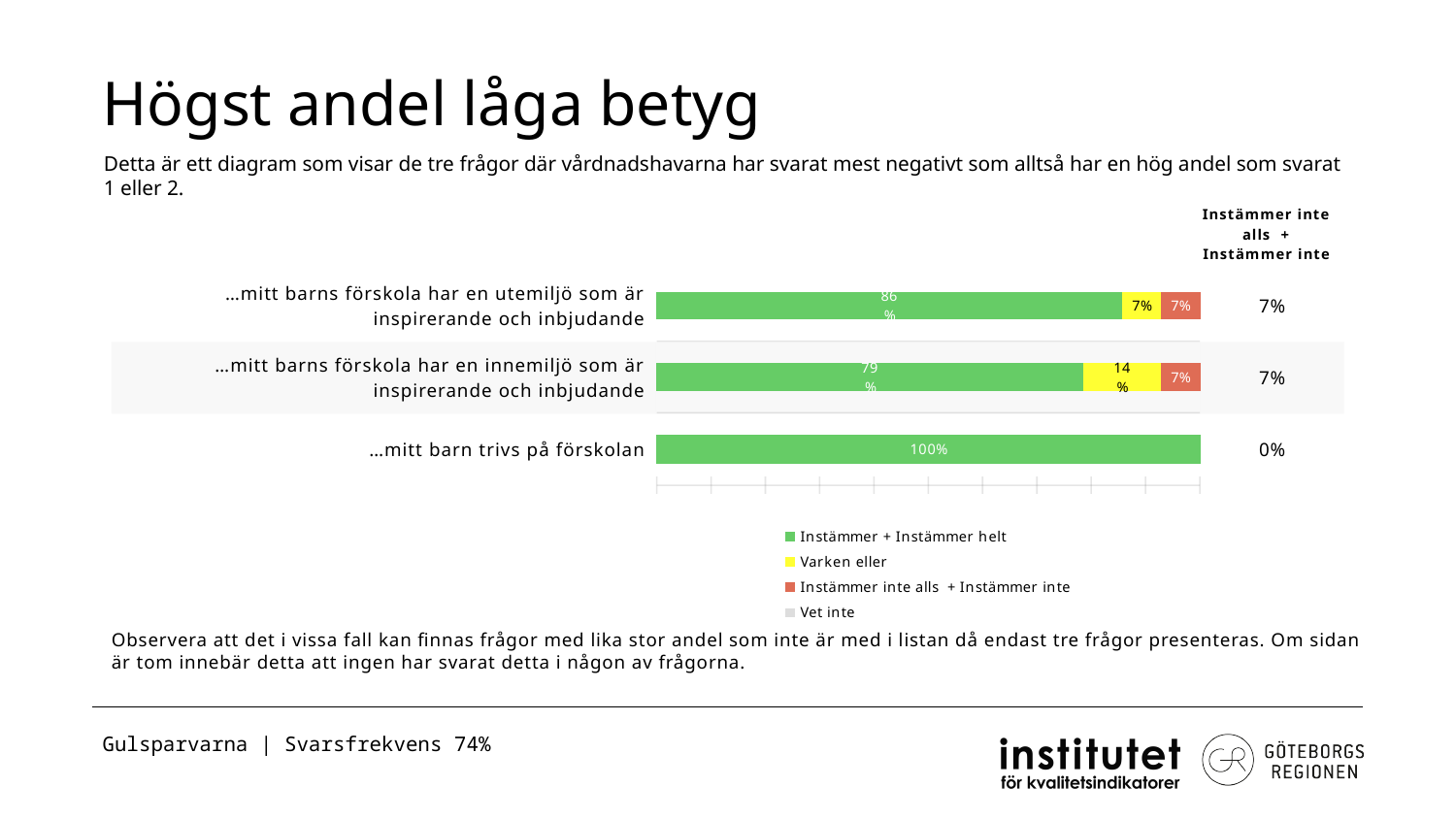
Which is larger: the "Varken eller" value for the utemiljö question or for the innemiljö question? innemiljö question (14%) What is the difference between the "Instämmer + Instämmer helt" values for the utemiljö question and the innemiljö question? 7% What is the value of "Varken eller" for "…mitt barns förskola har en innemiljö som är inspirerande och inbjudande"? 14% Which category has the highest value for "Instämmer + Instämmer helt"? …mitt barn trivs på förskolan How many categories (questions) are plotted in the chart? 3 How many series does the legend list? 4 Which category has the lowest value for "Instämmer + Instämmer helt"? …mitt barns förskola har en innemiljö som är inspirerande och inbjudande What kind of chart is shown on the slide? bar chart What is the value of "Instämmer + Instämmer helt" for "…mitt barns förskola har en innemiljö som är inspirerande och inbjudande"? 79% What is the value of "Instämmer + Instämmer helt" for "…mitt barn trivs på förskolan"? 100% What is the value of "Instämmer + Instämmer helt" for "…mitt barns förskola har en utemiljö som är inspirerande och inbjudande"? 86% What is the "Instämmer inte alls + Instämmer inte" value shown to the right of the bar for "…mitt barn trivs på förskolan"? 0%